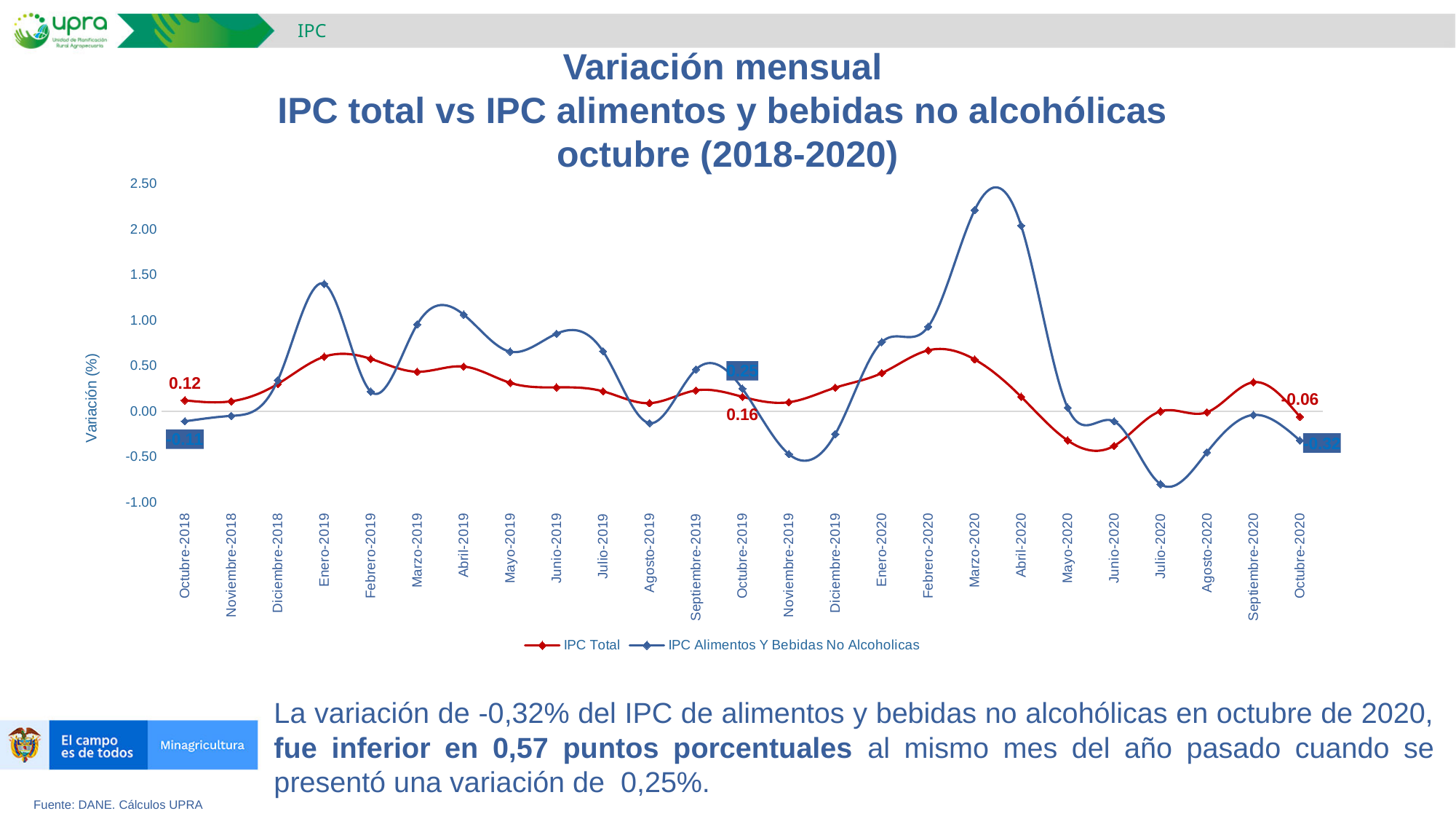
How many months are shown along the x axis? 25 What is the label of the vertical axis? Variación (%) How many series does the legend list? 2 What is the difference between the IPC Total values for Octubre-2018 and Octubre-2020? 0.18 What is the IPC Total value for Octubre-2018? 0.12 Is the IPC Alimentos Y Bebidas No Alcoholicas value for Enero-2019 greater or less than 1.00? greater Which is larger, the IPC Total value for Octubre-2018 or for Octubre-2019? Octubre-2019 What is the IPC Total value for Octubre-2020? -0.06 In which month does the IPC Alimentos Y Bebidas No Alcoholicas series reach its lowest value? Julio-2020 What is the IPC Total value for Octubre-2019? 0.16 In which month does the IPC Alimentos Y Bebidas No Alcoholicas series reach its highest value? Marzo-2020 What kind of chart is shown on the slide? Line chart